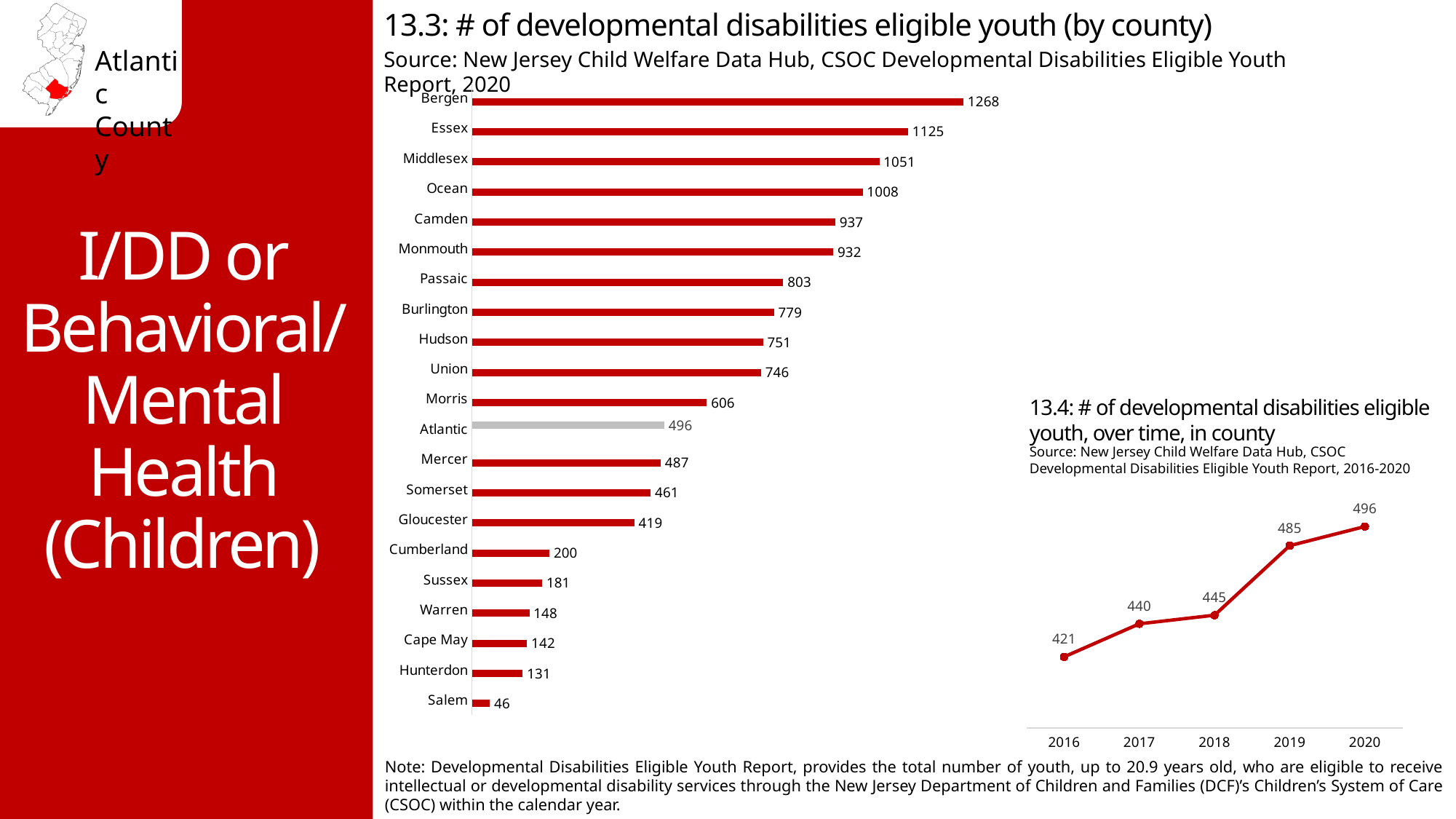
In chart 13.3 (by county), how many counties are shown? 21 In chart 13.4 (over time, in county), what is the value for 2018? 445 In chart 13.3 (by county), which county has the lowest number of developmental disabilities eligible youth? Salem What type of chart is chart 13.3 (by county)? Bar chart In chart 13.4 (over time, in county), what is the difference between the 2020 and 2016 values? 75 In chart 13.3 (by county), which has a larger value, Morris or Mercer? Morris In chart 13.3 (by county), which bar is shown in a different colour (grey) from the others? Atlantic In chart 13.3 (# of developmental disabilities eligible youth by county), what is the value for Atlantic? 496 In chart 13.3 (by county), what is the difference between the values for Bergen and Essex? 143 In chart 13.4 (over time, in county), do the values rise or fall from 2016 to 2020? Rise In chart 13.3 (by county), what is the value for Camden? 937 In chart 13.3 (by county), which county has the highest number of developmental disabilities eligible youth? Bergen